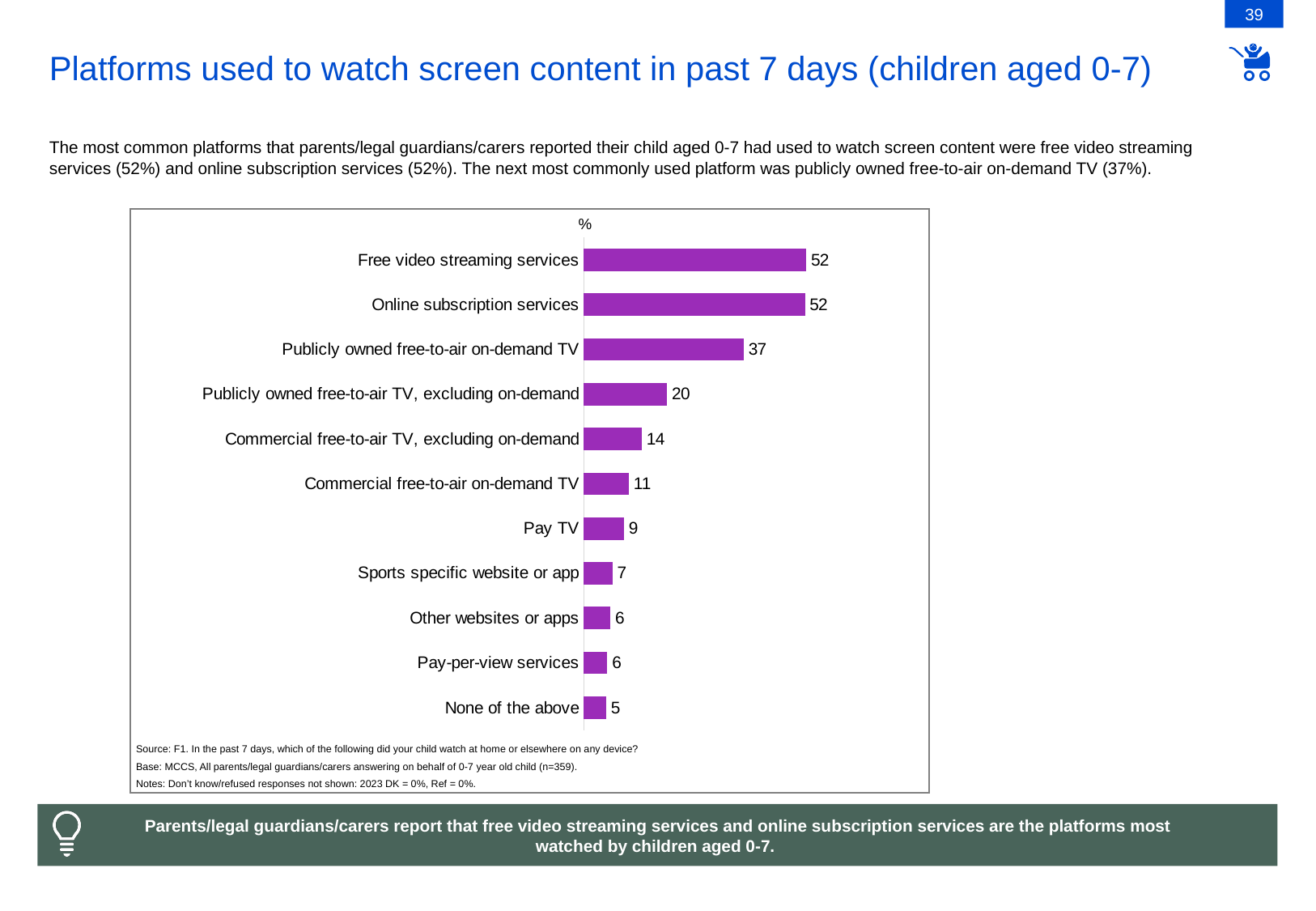
What is the value shown for Publicly owned free-to-air on-demand TV? 37 What is the value shown for Pay TV? 9 What percentage of children aged 0-7 used free video streaming services in the past 7 days? 52 What is the difference between the values for Commercial free-to-air TV, excluding on-demand and Commercial free-to-air on-demand TV? 3 How many platform categories are shown in the chart? 11 What is the difference between the values for Publicly owned free-to-air on-demand TV and Publicly owned free-to-air TV, excluding on-demand? 17 What is the value shown for None of the above? 5 What type of chart is shown on the slide? Bar chart Which platform has the lowest value in the chart? None of the above Which is larger: the value for Pay TV or the value for Pay-per-view services? Pay TV Which is larger: the value for Sports specific website or app or the value for Other websites or apps? Sports specific website or app What colour are the bars in the chart? Purple